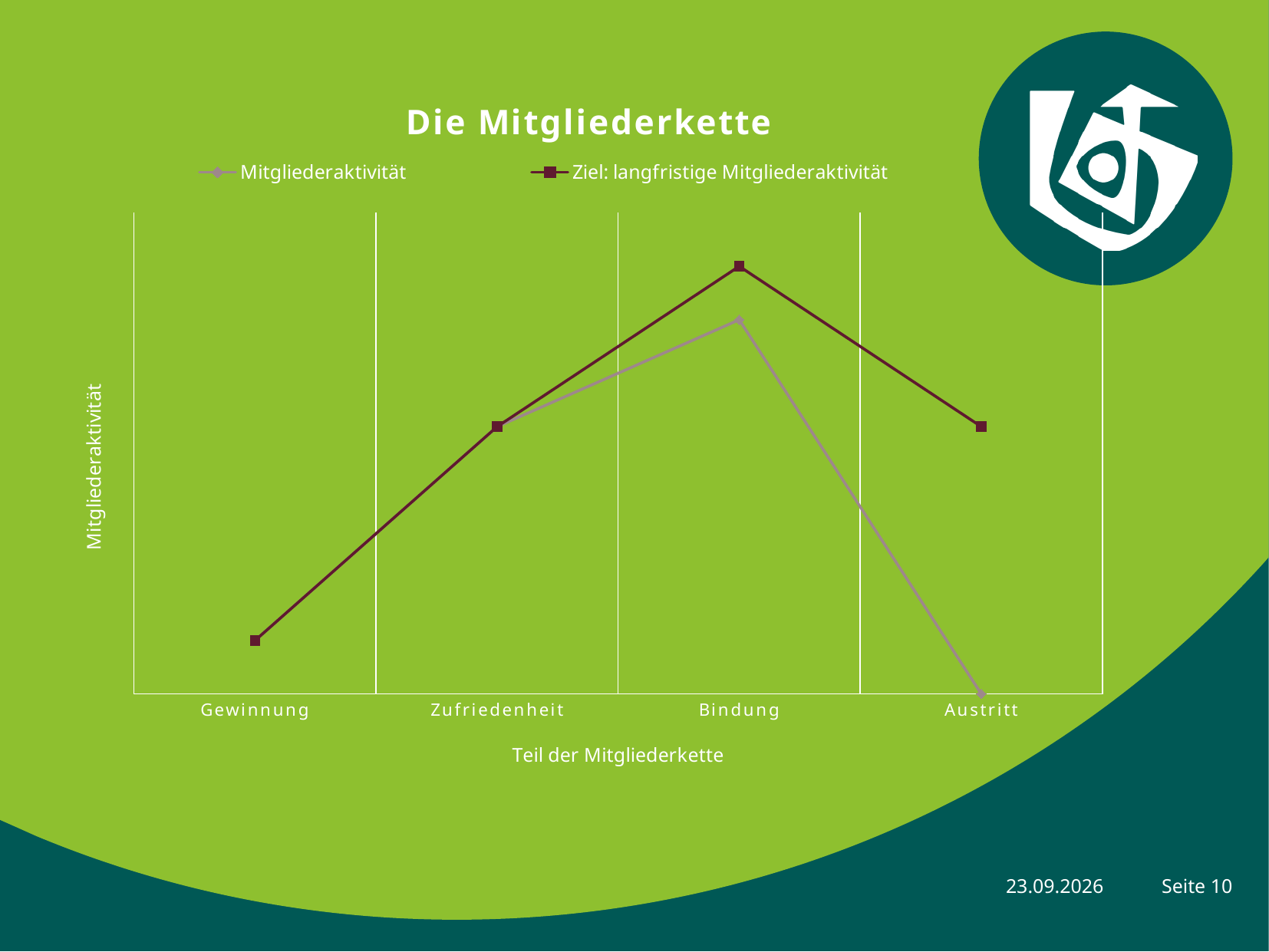
Does the Mitgliederaktivität series rise or fall from Bindung to Austritt? fall Does the Ziel: langfristige Mitgliederaktivität series rise or fall from Gewinnung to Bindung? rise For the Ziel: langfristige Mitgliederaktivität series, which category has the lowest value? Gewinnung At Austritt, which series has the larger value: Mitgliederaktivität or Ziel: langfristige Mitgliederaktivität? Ziel: langfristige Mitgliederaktivität At Bindung, which series has the larger value: Mitgliederaktivität or Ziel: langfristige Mitgliederaktivität? Ziel: langfristige Mitgliederaktivität What is the title of the chart? Die Mitgliederkette For the Mitgliederaktivität series, which category has the lowest value? Austritt What kind of chart is shown on the slide? line chart How many series does the legend list? 2 For the Ziel: langfristige Mitgliederaktivität series, which category has the highest value? Bindung For the Mitgliederaktivität series, which category has the highest value? Bindung How many categories are shown on the x axis? 4